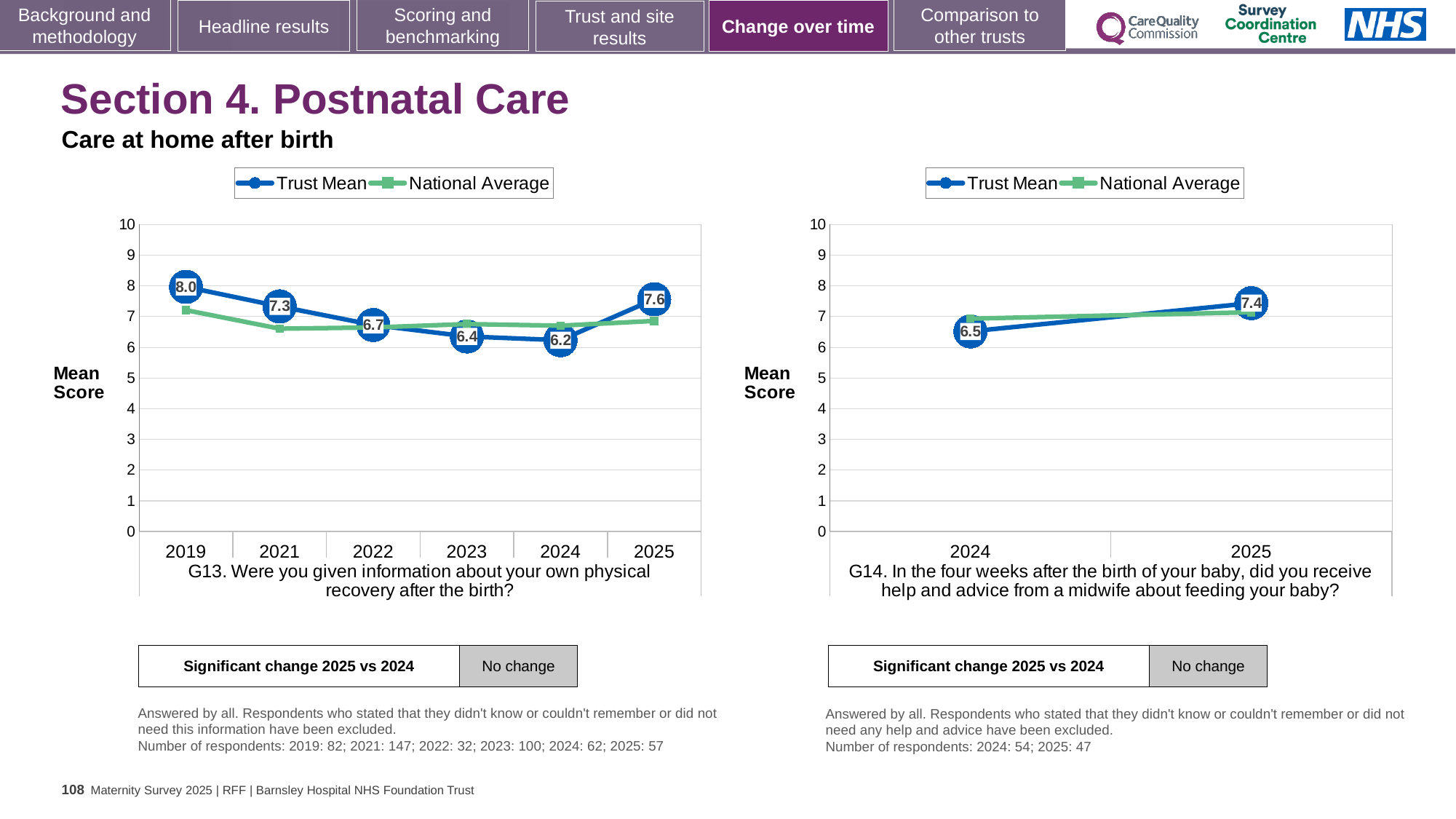
How many series does the legend of the G14 chart on the right list? 2 In the G13 chart on the left, is the Trust Mean score for 2021 higher or lower than for 2022? higher In the G13 chart on the left, what is the difference between the Trust Mean scores for 2025 and 2024? 1.4 What type of chart is the G13 chart on the left? line chart How many years are shown on the x axis of the G13 chart on the left? 6 In the G13 chart on the left, which year has the highest Trust Mean score? 2019 In the G14 chart on the right, what is the Trust Mean score for 2025? 7.4 In the G14 chart on the right, what is the difference between the Trust Mean scores for 2025 and 2024? 0.9 In the G13 chart on the left, what is the Trust Mean score for 2019? 8.0 In the G13 chart on the left, which year has the lowest Trust Mean score? 2024 In the G14 chart on the right, is the National Average value for 2024 greater or less than 6? greater In the G13 chart on the left, what is the Trust Mean score for 2024? 6.2